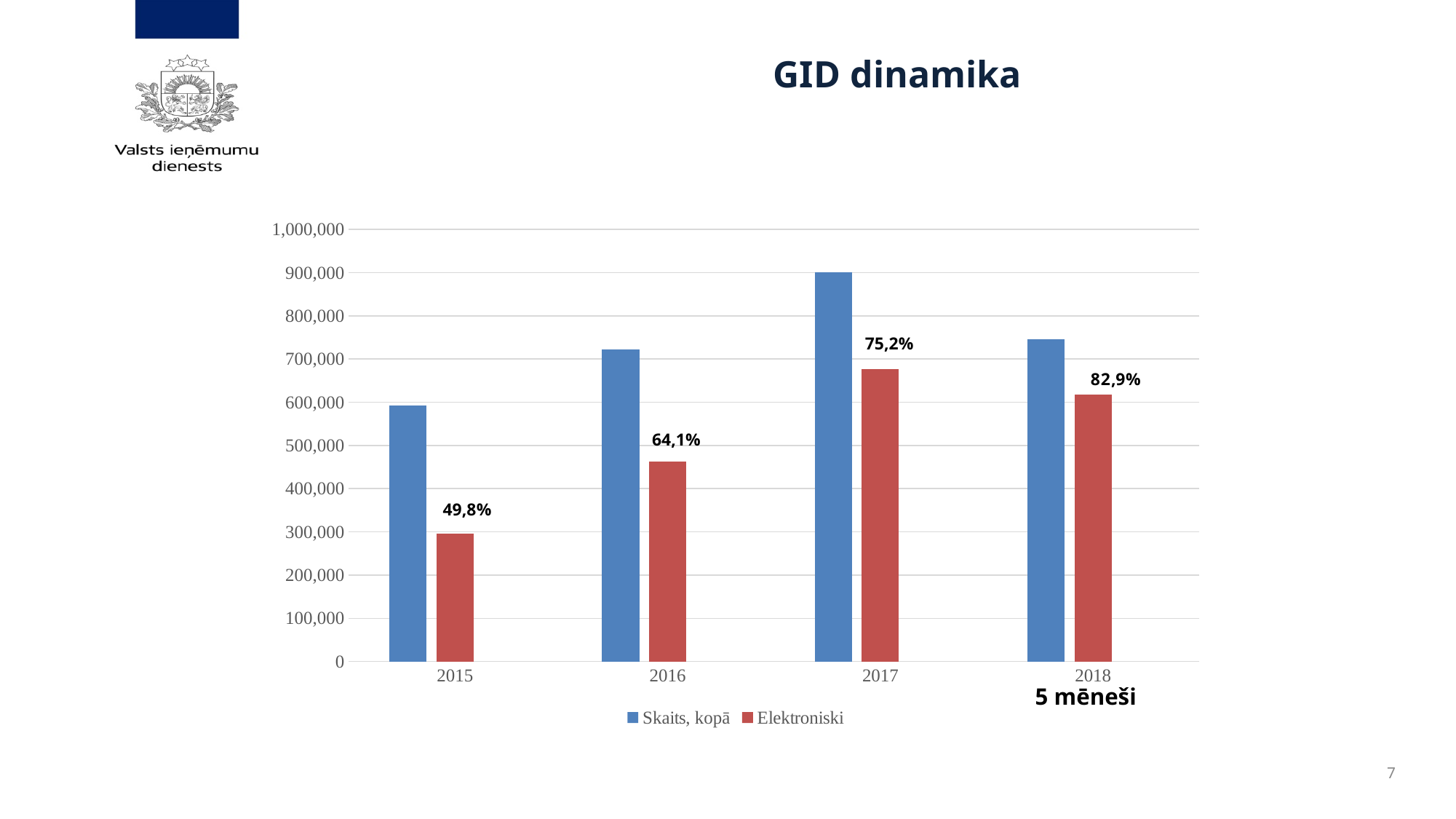
Is the Elektroniski value for 2016 greater or less than 500,000? less Is the Skaits, kopā value for 2017 greater or less than 800,000? greater In which year is the Elektroniski bar the lowest? 2015 What percentage label is shown above the Elektroniski bar for 2018? 82,9% What is the title of the chart? GID dinamika What percentage label is shown above the Elektroniski bar for 2017? 75,2% In which year is the Skaits, kopā bar the highest? 2017 What type of chart is shown on the slide? bar chart What percentage label is shown above the Elektroniski bar for 2015? 49,8% How many years are shown on the x axis? 4 How many series does the legend list? 2